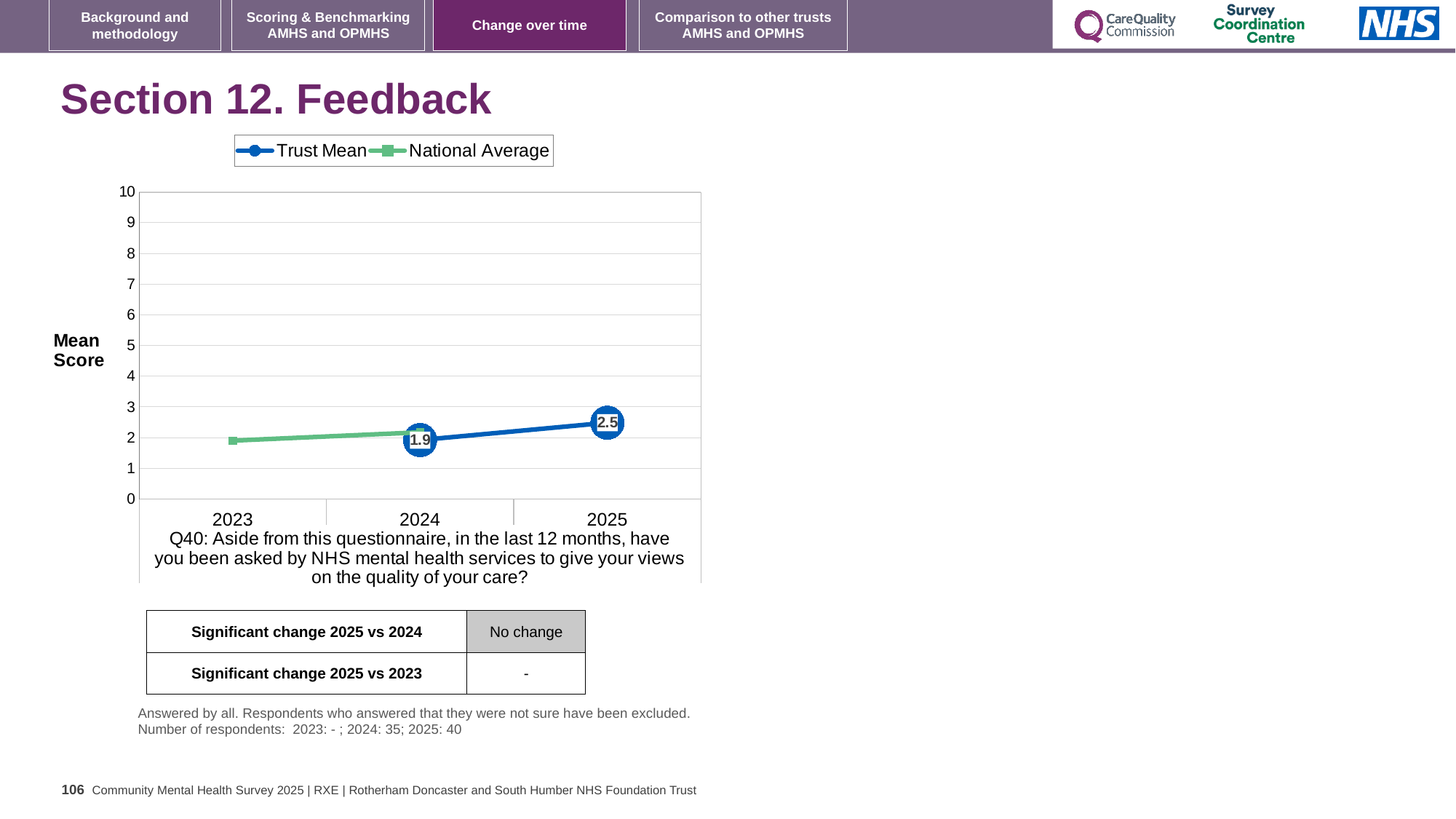
How many series does the legend list? 2 What is the Trust Mean value for 2025? 2.5 Which series is shown in green in the legend? National Average By how much did the Trust Mean change from 2024 to 2025? 0.6 What kind of chart is shown on the slide? line chart How many years are shown on the x axis of the chart? 3 Is the Trust Mean value for 2025 greater or less than 3? less Which year has the higher Trust Mean, 2024 or 2025? 2025 Is the National Average value for 2023 greater or less than 3? less What is the Trust Mean value for 2024? 1.9 Does the Trust Mean rise or fall from 2024 to 2025? rise What is the label of the y axis of the chart? Mean Score